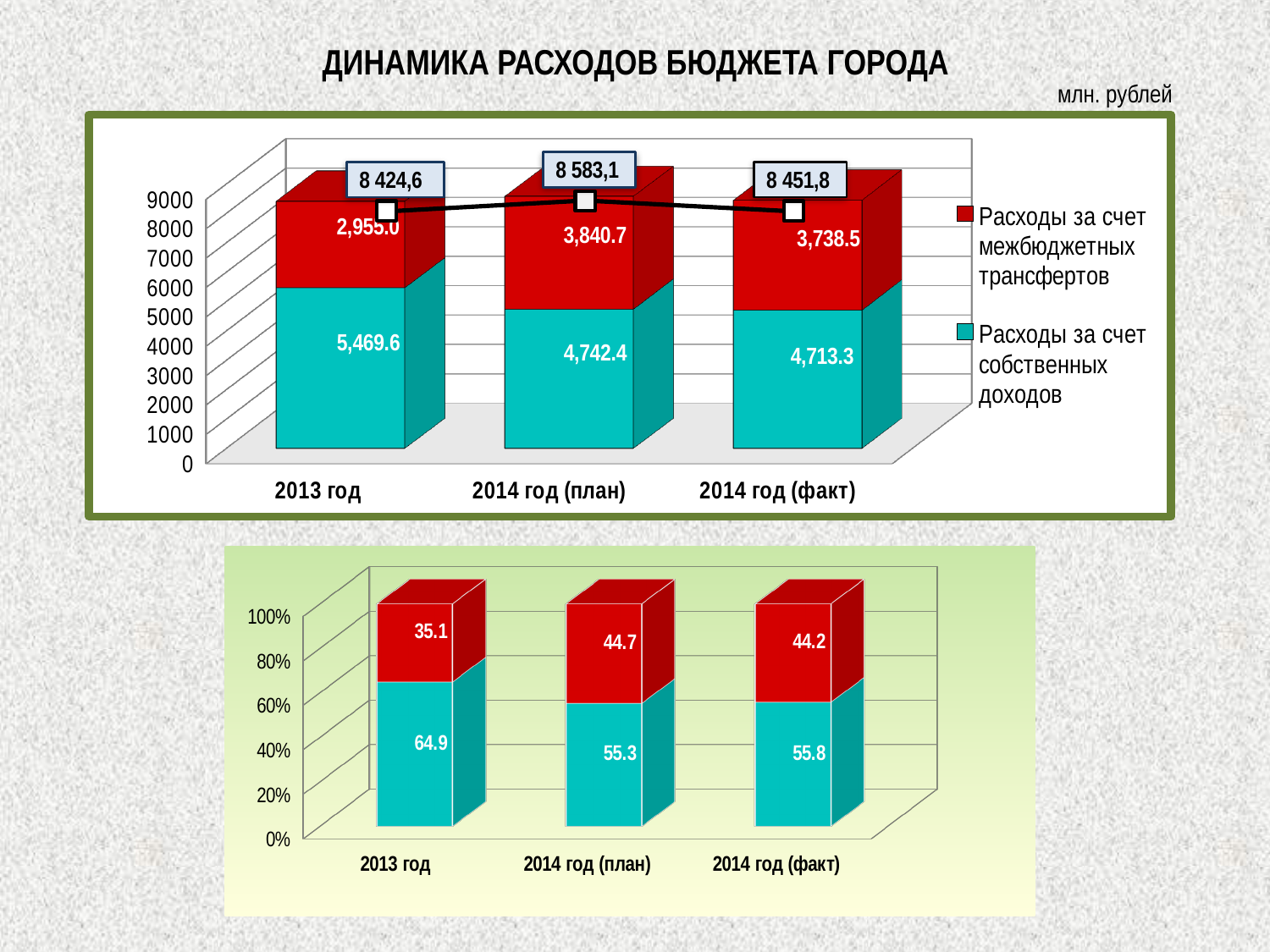
How many series does the legend of the top chart list? 2 In the top chart, what is the value of 'Расходы за счет собственных доходов' for 2013 год? 5,469.6 In the top chart, what total is shown above the bar for 2014 год (факт)? 8 451,8 In the bottom chart, what is the value of the red segment for 2013 год? 35.1 In the top chart, which category has the lowest value for 'Расходы за счет собственных доходов'? 2014 год (факт) In the bottom chart, what is the value of the teal segment for 2014 год (план)? 55.3 How many categories are shown on the x axis of the bottom chart? 3 In the top chart, is 'Расходы за счет межбюджетных трансфертов' larger for 2014 год (план) or for 2014 год (факт)? 2014 год (план) In the top chart, what is the value of 'Расходы за счет межбюджетных трансфертов' for 2014 год (план)? 3,840.7 In the top chart, what is the difference between 'Расходы за счет собственных доходов' for 2013 год and for 2014 год (факт)? 756.3 In the top chart, which category has the highest value for 'Расходы за счет межбюджетных трансфертов'? 2014 год (план) What kind of chart is the bottom chart? Stacked bar chart